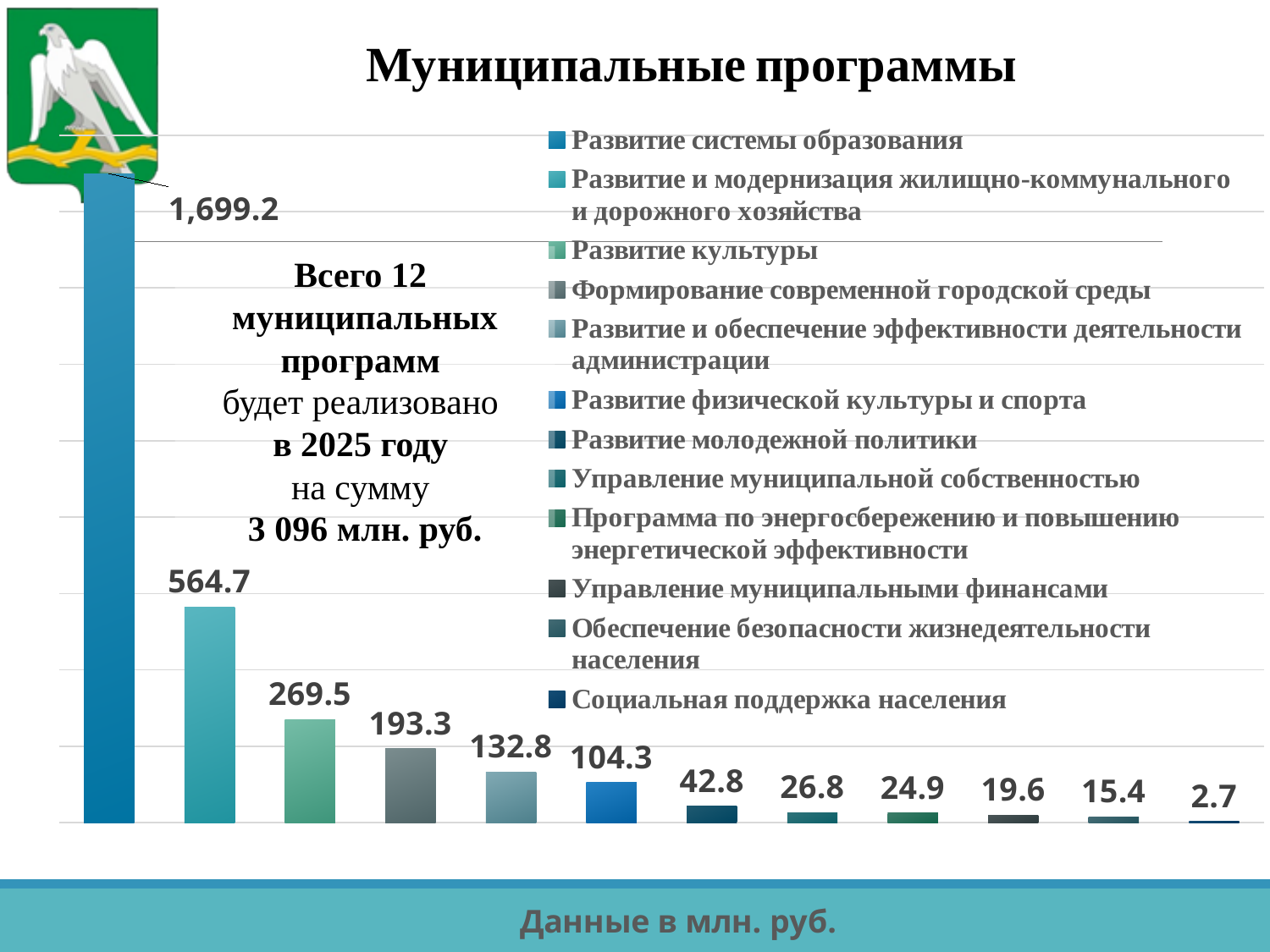
What is the value for "Развитие культуры"? 269.5 How many series does the legend list? 12 What kind of chart is shown on the slide? bar chart Which program has the lowest value in the chart? Социальная поддержка населения Which program has the highest value in the chart? Развитие системы образования Which is larger: the value for "Развитие физической культуры и спорта" or for "Развитие молодежной политики"? Развитие физической культуры и спорта What is the value for "Развитие и модернизация жилищно-коммунального и дорожного хозяйства"? 564.7 How many bars are plotted in the chart? 12 Do the bar values rise or fall from left to right across the chart? fall What is the difference between the values for "Развитие системы образования" and "Развитие и модернизация жилищно-коммунального и дорожного хозяйства"? 1,134.5 What is the value for "Социальная поддержка населения"? 2.7 What is the value for "Развитие системы образования"? 1,699.2